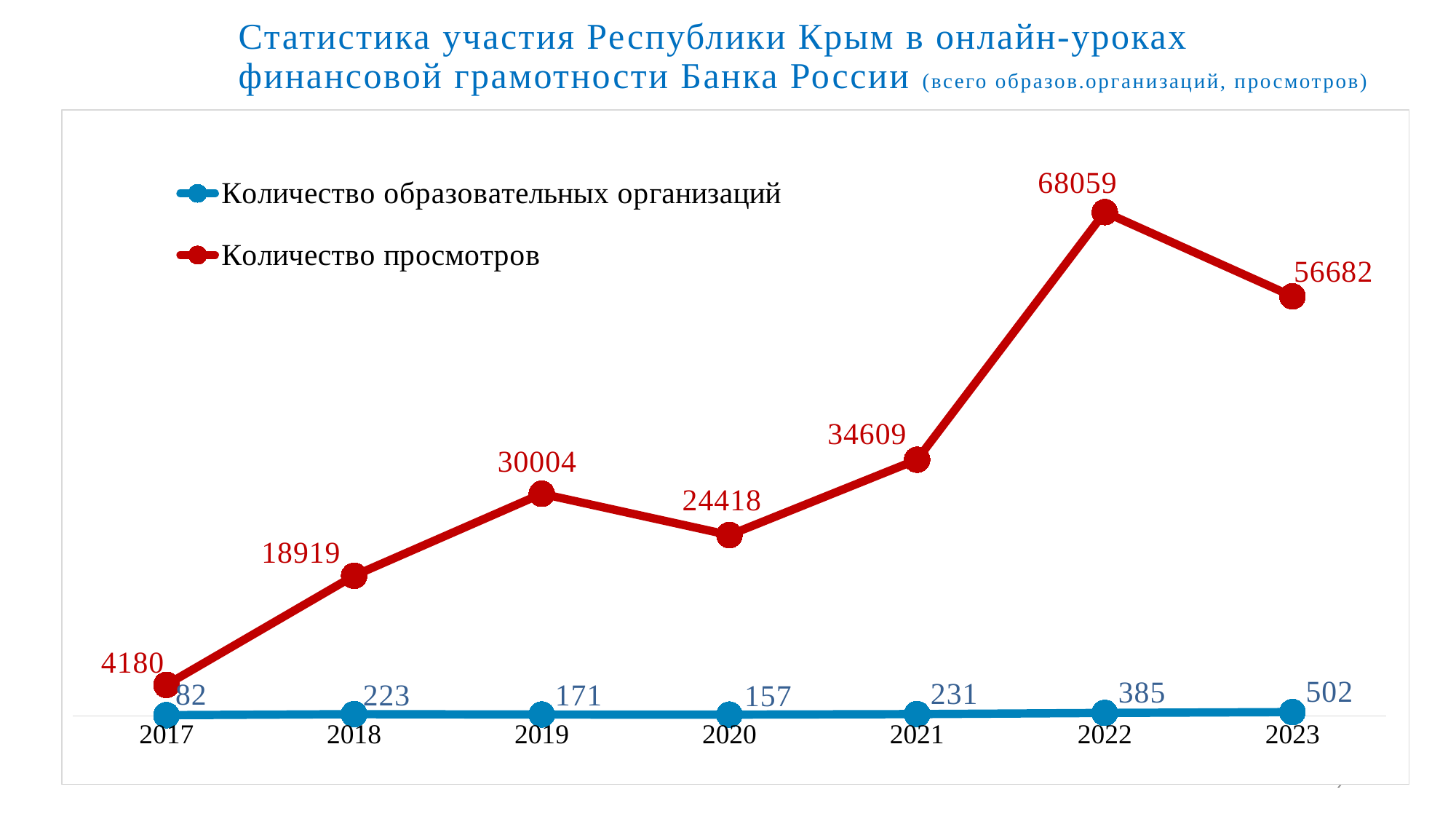
What is the value of "Количество просмотров" in 2017? 4180 How many years are plotted along the x axis? 7 What is the difference between "Количество просмотров" in 2022 and in 2023? 11377 What is the value of "Количество просмотров" in 2022? 68059 Does "Количество образовательных организаций" rise or fall from 2022 to 2023? rise How many series does the legend list? 2 In which year is "Количество просмотров" highest? 2022 What type of chart is shown on the slide? line chart Which year has the larger value of "Количество просмотров": 2019 or 2020? 2019 What colour is the line for "Количество просмотров"? red What is the value of "Количество образовательных организаций" in 2019? 171 In which year is "Количество образовательных организаций" lowest? 2017